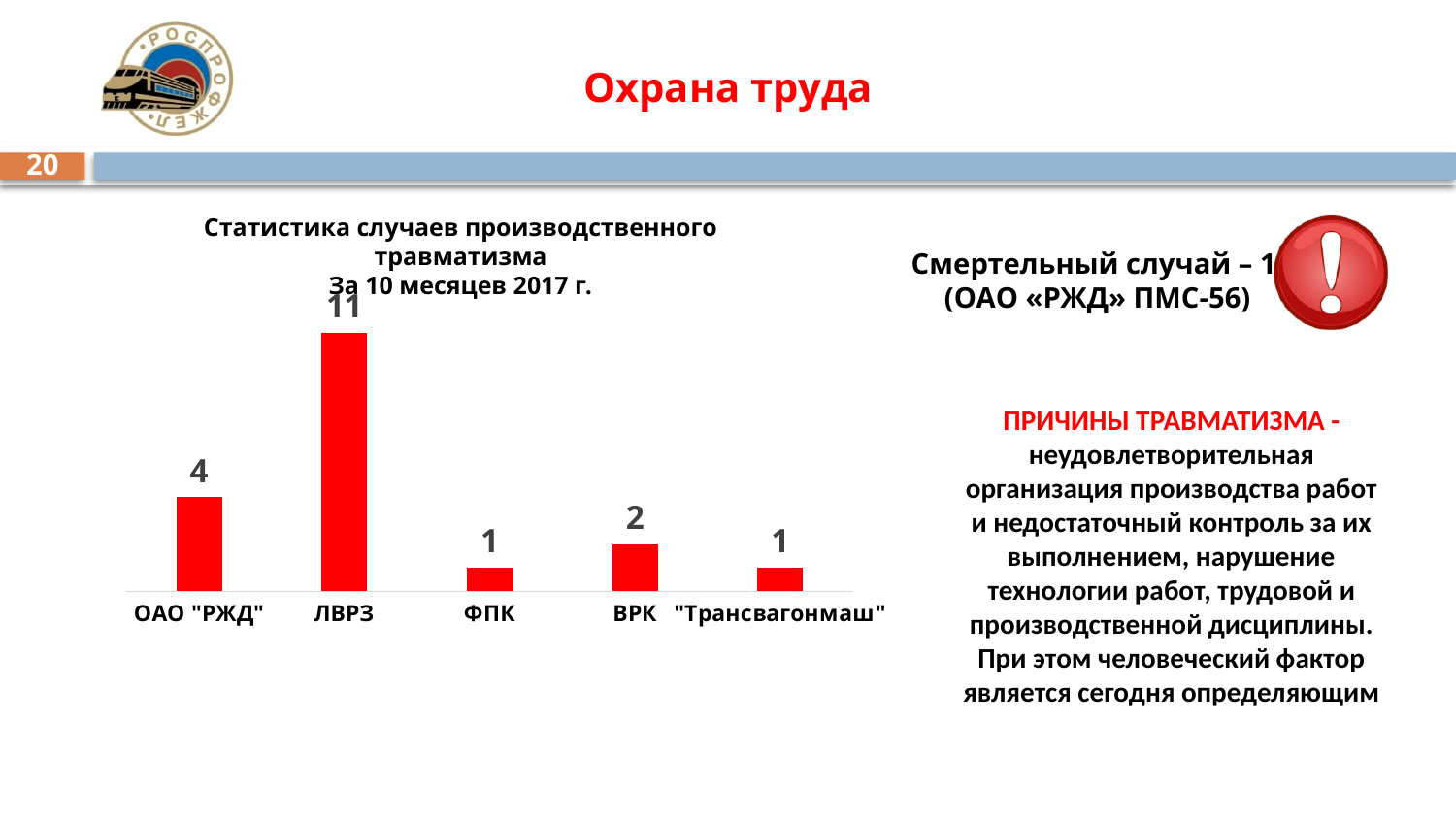
What is the value for ОАО "РЖД"? 4 What is the title of the chart? Статистика случаев производственного травматизма За 10 месяцев 2017 г. What is the value for ЛВРЗ? 11 What is the difference between the values for ОАО "РЖД" and ВРК? 2 What is the difference between the values for ЛВРЗ and ОАО "РЖД"? 7 How many categories are shown on the x axis? 5 What is the value for ВРК? 2 What is the value for ФПК? 1 Which category has the highest value? ЛВРЗ Which is larger, the value for ВРК or the value for "Трансвагонмаш"? ВРК What kind of chart is shown on the slide? bar chart What colour are the bars in the chart? red